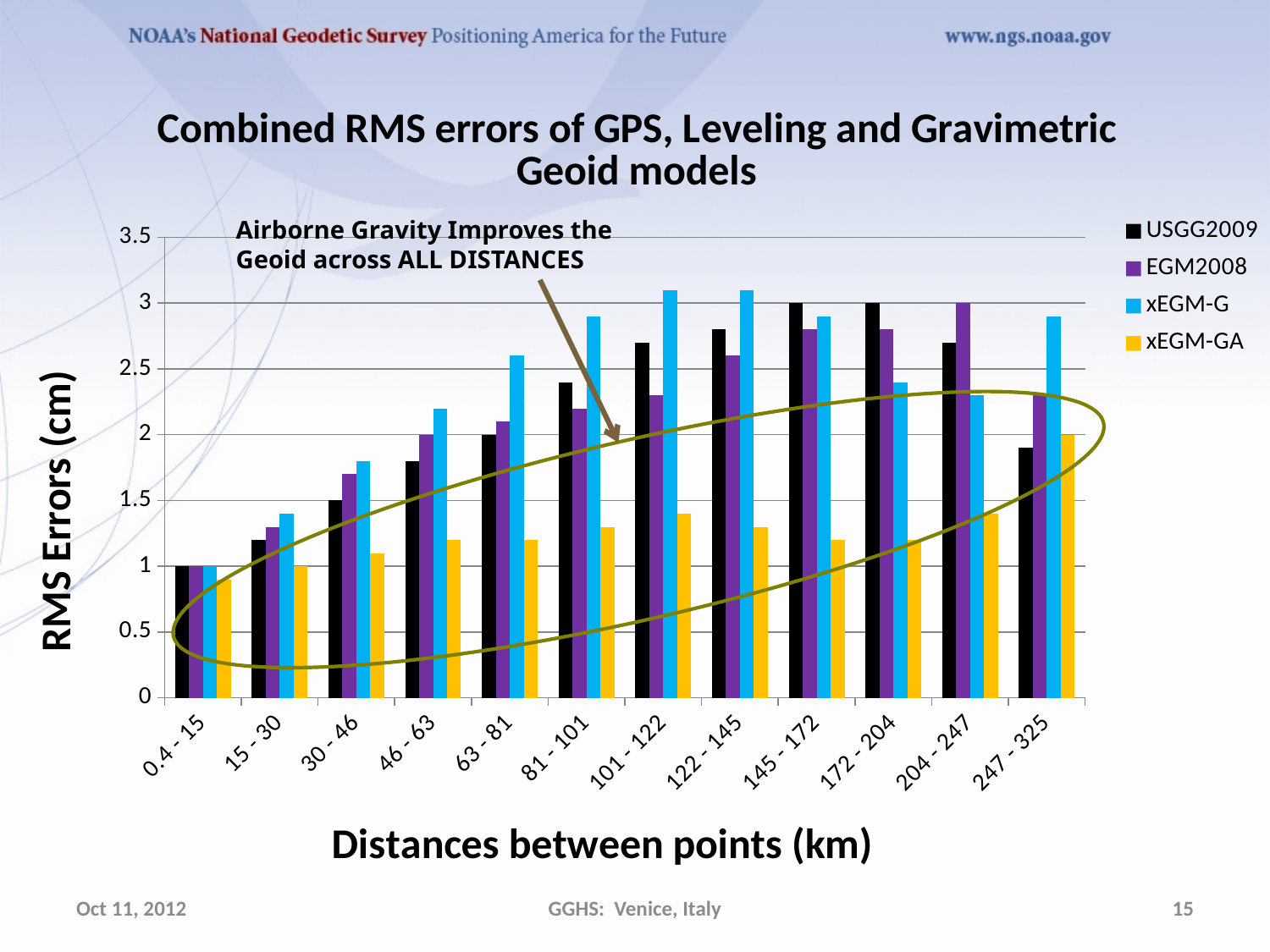
Is the value for xEGM-G in the 46 - 63 km category greater or less than 2? greater Is the value for xEGM-GA in the 81 - 101 km category greater or less than 1.5? less What is the RMS error for USGG2009 in the 0.4 - 15 km category? 1 How many series does the legend list? 4 What kind of chart is shown on the slide? bar chart What is the RMS error for xEGM-GA in the 247 - 325 km category? 2 What is the label of the y axis? RMS Errors (cm) In the 247 - 325 km category, which is larger: xEGM-G or USGG2009? xEGM-G How many distance categories are shown on the x axis? 12 Which series has the lowest RMS error in the 122 - 145 km category? xEGM-GA What is the RMS error for USGG2009 in the 145 - 172 km category? 3 Do the USGG2009 values rise or fall from 0.4 - 15 km to 145 - 172 km? rise